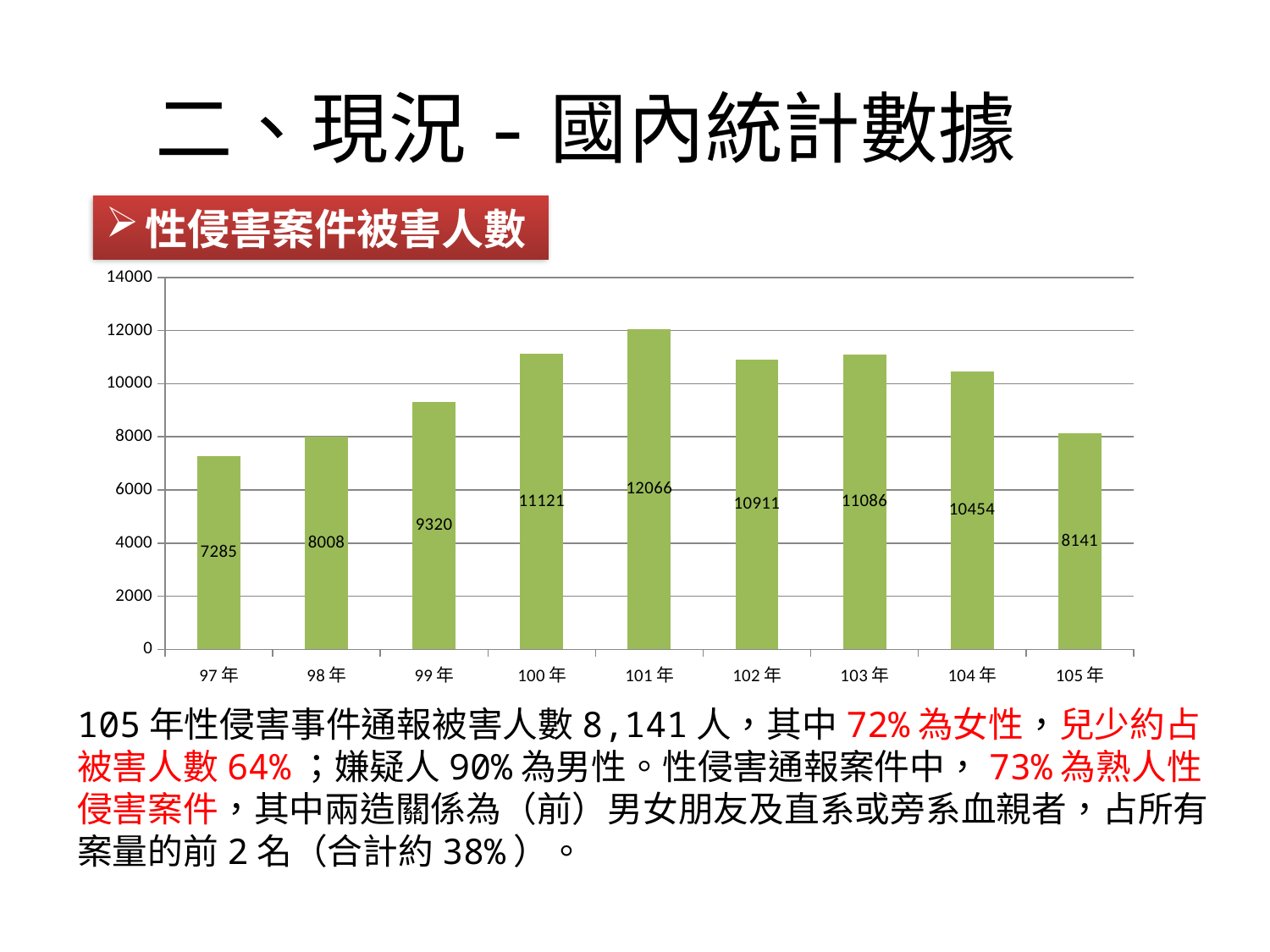
What is the value for 105年? 8141 What is the value for 97年? 7285 What is the difference between the values for 101年 and 97年? 4781 What kind of chart is this? bar chart Which is larger, the value for 100年 or the value for 103年? 100年 What is the value for 101年? 12066 What is the difference between the values for 104年 and 105年? 2313 Which year has the lowest value? 97年 How many years are shown on the x axis? 9 Which year has the highest value? 101年 Is the value for 99年 greater or less than 10000? less Do the values rise or fall from 97年 to 101年? rise